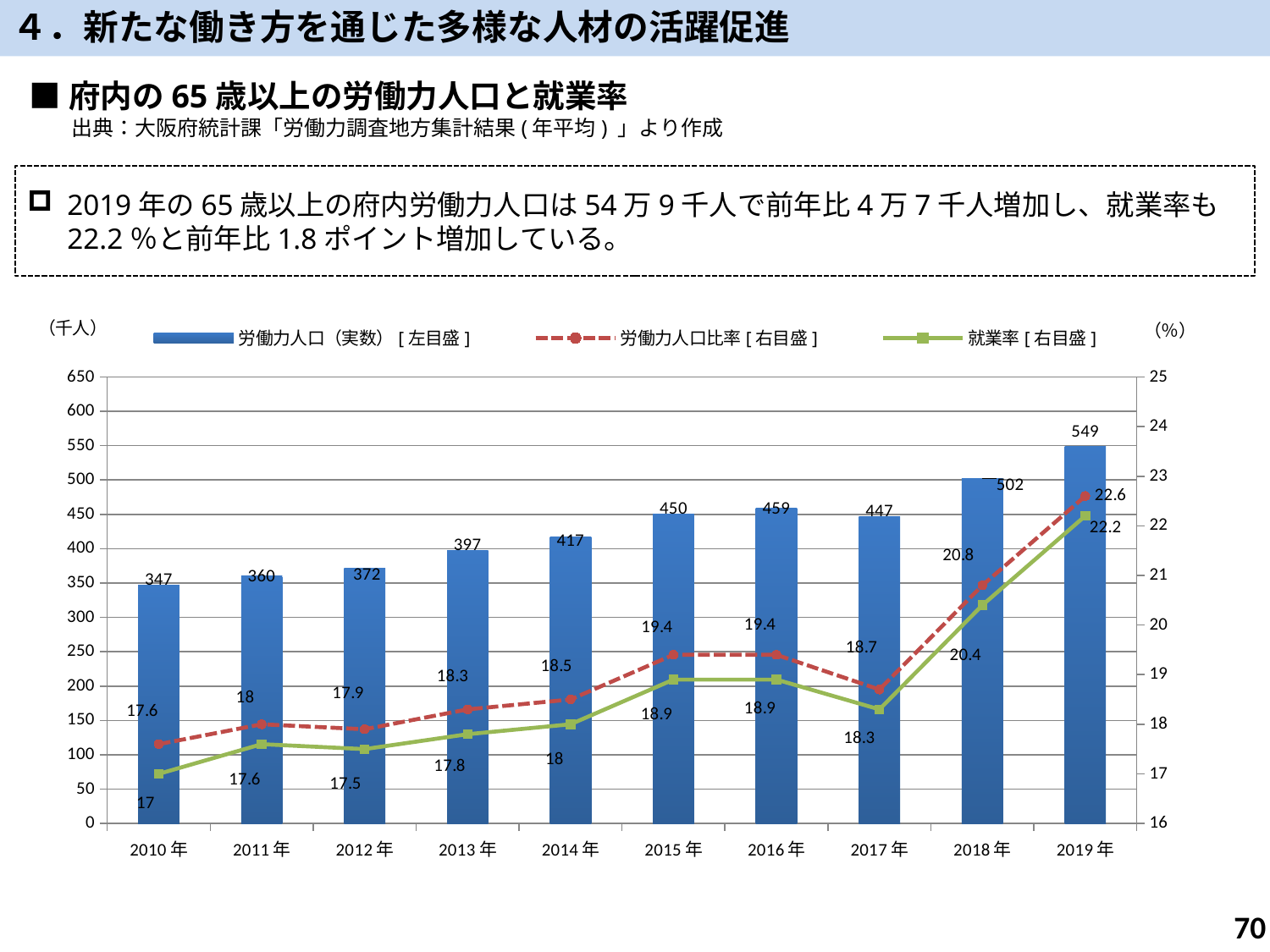
Does the 就業率 line rise or fall from 2017年 to 2019年? rise Which year has the lowest 就業率 value? 2010年 Is the 労働力人口（実数） bar for 2013年 greater or less than 400? less What is the 就業率 value for 2017年? 18.3 What kind of chart is used for the 労働力人口（実数） series? bar chart What is the 労働力人口比率 value for 2018年? 20.8 Which is larger, the 労働力人口（実数） value for 2016年 or for 2017年? 2016年 How many years are shown on the x axis of the chart? 10 Which year has the highest 労働力人口（実数） bar? 2019年 What is the difference between the 労働力人口（実数） values for 2019年 and 2018年? 47 What is the value of 労働力人口（実数） for 2019年? 549 How many series does the chart legend list? 3